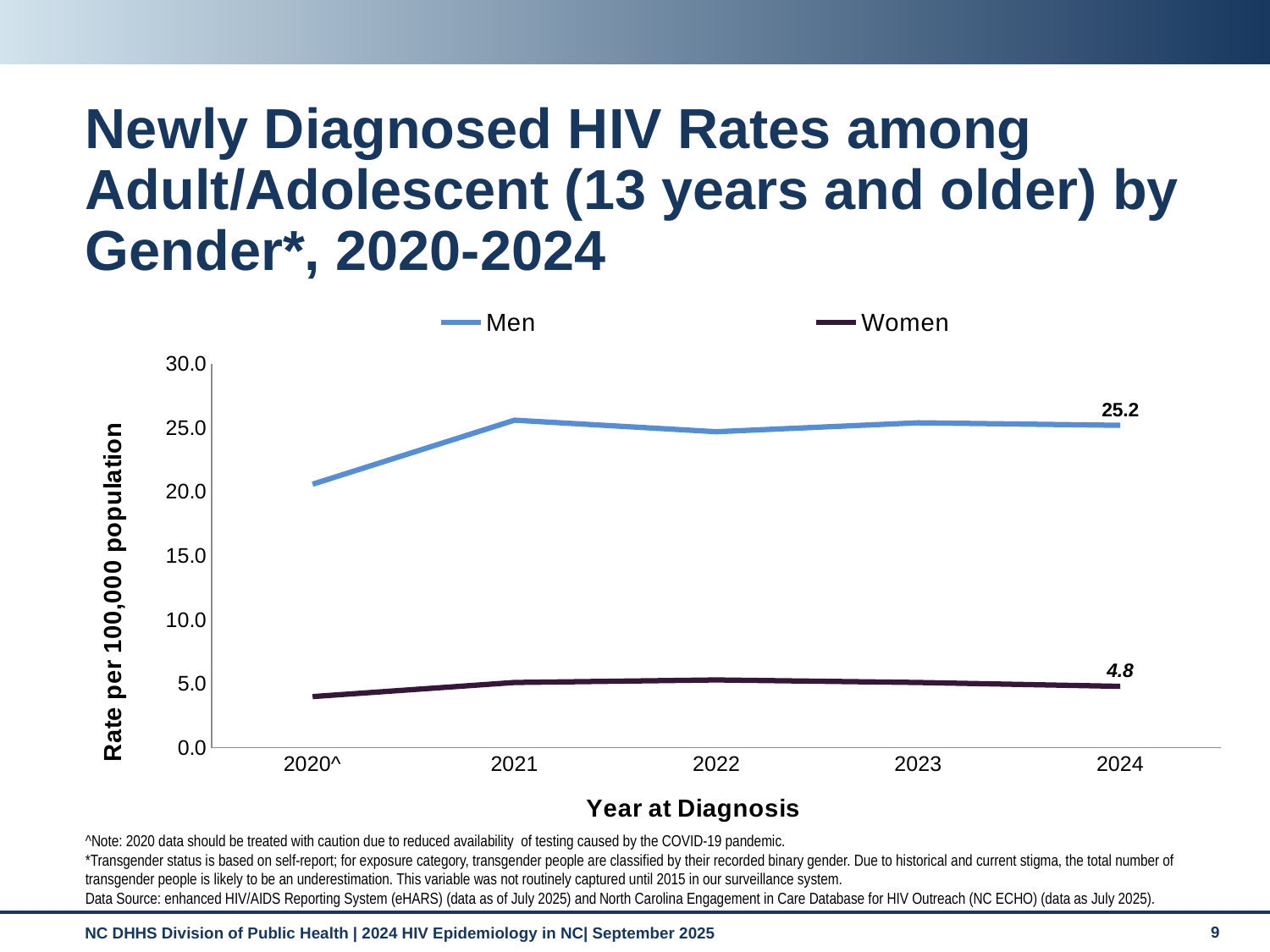
In 2024, which series has the higher rate, Men or Women? Men In which year is the Men rate lowest? 2020^ Is the value for Men in 2020^ greater or less than 25.0? less How many series does the legend list? 2 What is the rate for Men in 2024? 25.2 What kind of chart is shown on the slide? line chart What is the rate for Women in 2024? 4.8 Is the value for Women in 2020^ greater or less than 5.0? less In which year is the Women rate lowest? 2020^ What is the difference between the Men and Women rates in 2024? 20.4 Does the Men rate rise or fall from 2020^ to 2021? rise How many years are shown on the x axis? 5